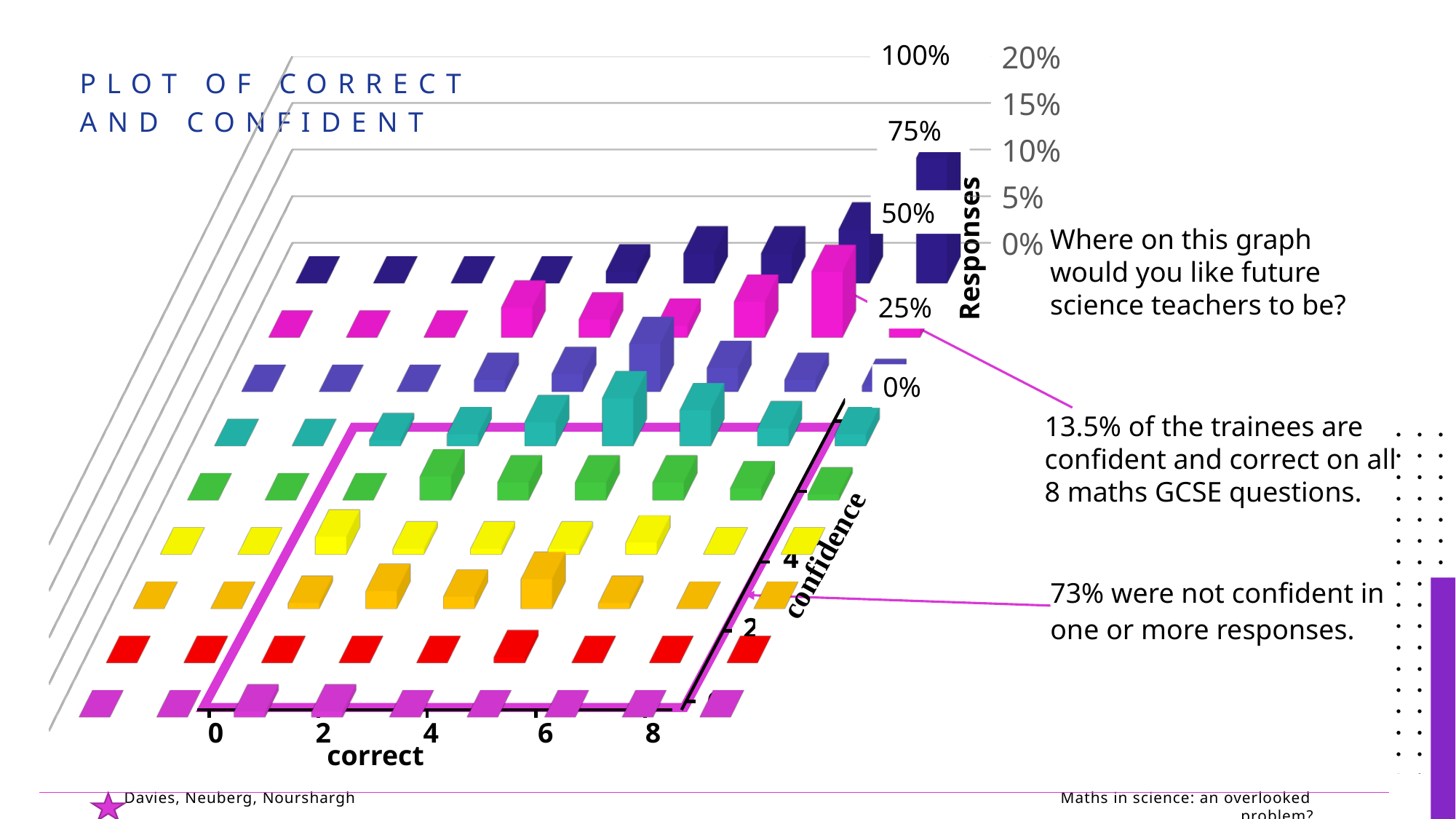
What is the highest value on the horizontal 'correct' axis? 8 What is the title of the chart on the slide? PLOT OF CORRECT AND CONFIDENT According to the annotation, what percentage of trainees were not confident in one or more responses? 73% What is the highest tick value shown on the Responses axis (the grey percentage scale)? 20% According to the annotation, what percentage of trainees are confident and correct on all 8 maths GCSE questions? 13.5% What is the interval between labelled ticks on the grey Responses axis? 5% What is the label of the horizontal axis of the chart? correct How many labelled tick marks are shown on the 'correct' axis? 5 What kind of chart is shown on the slide? bar chart